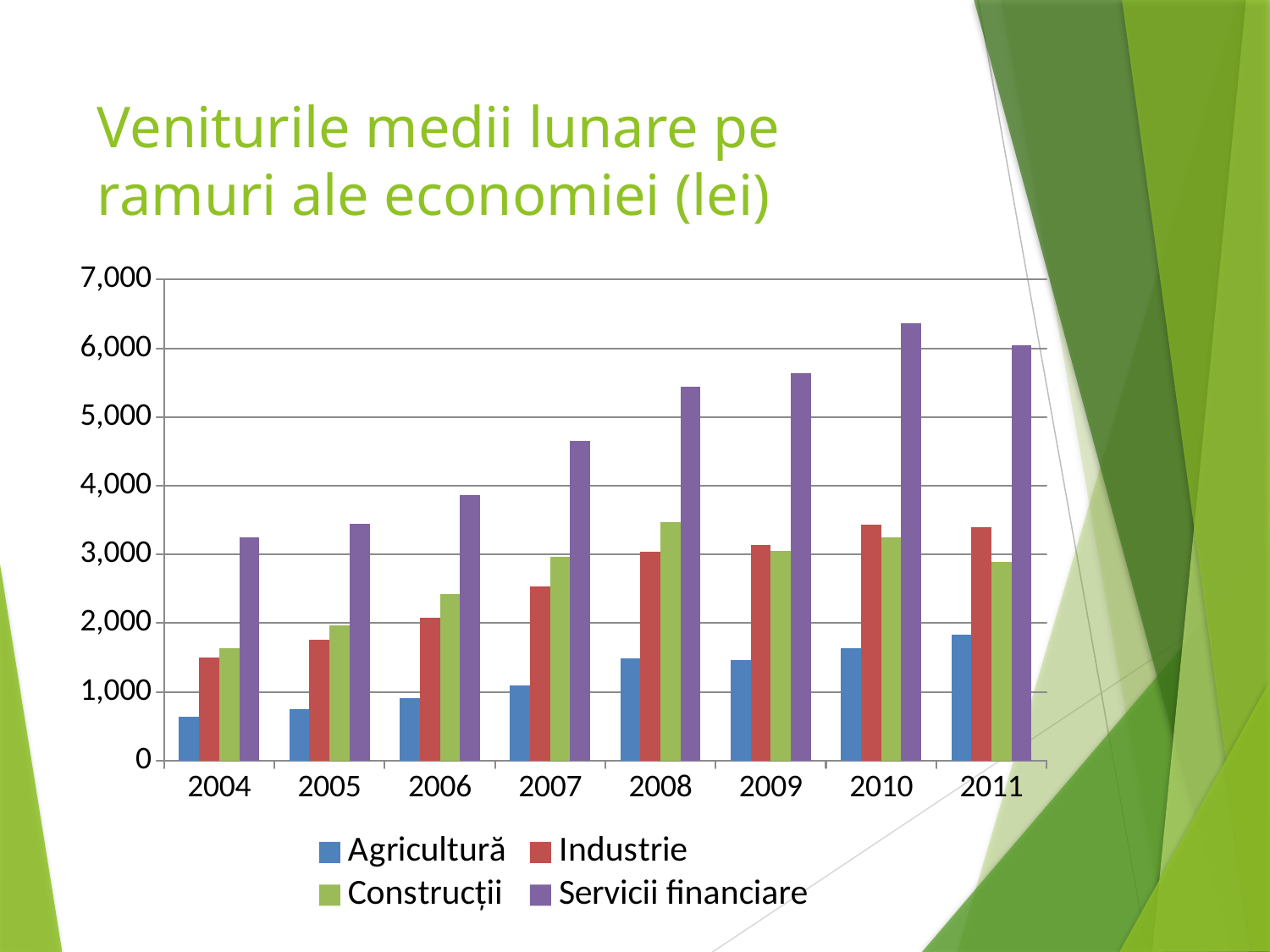
Is the value for Agricultură in 2004 greater or less than 1,000? less Do the values for Servicii financiare rise or fall from 2004 to 2010? rise In 2008, which is larger: Construcții or Industrie? Construcții Is the value for Servicii financiare in 2010 greater or less than 6,000? greater What is the title of the chart on the slide? Veniturile medii lunare pe ramuri ale economiei (lei) In which year is the value for Agricultură the lowest? 2004 How many series does the legend list? 4 In which year is the value for Servicii financiare the highest? 2010 Is the value for Industrie in 2007 greater or less than 3,000? less In 2011, which is larger: Industrie or Construcții? Industrie What kind of chart is shown on the slide? Bar chart How many years are shown on the x axis? 8